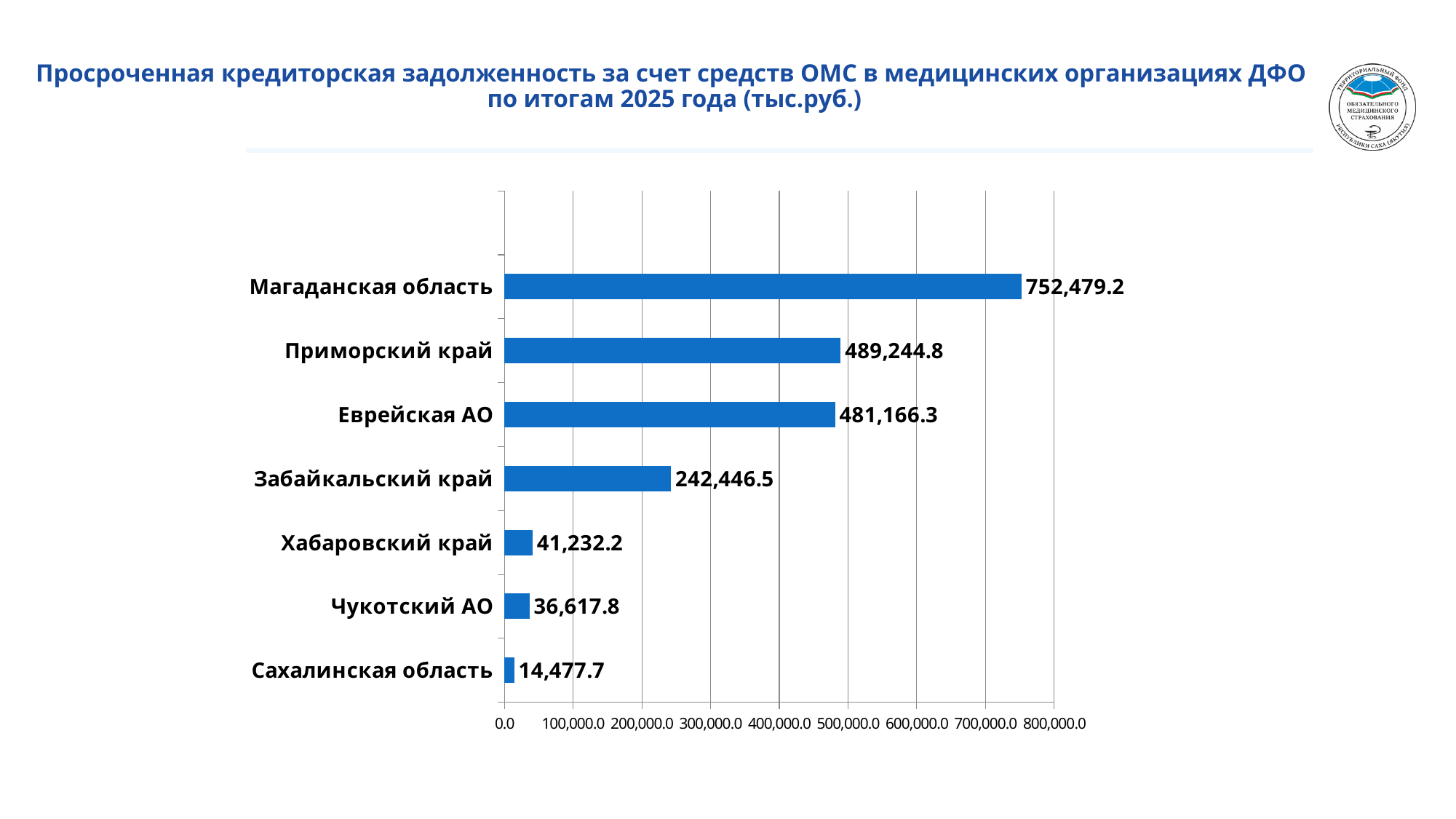
Is the value for Забайкальский край greater or less than 200,000.0? greater Which is larger, the value for Еврейская АО or the value for Забайкальский край? Еврейская АО Which region has the lowest value? Сахалинская область What is the value for Чукотский АО? 36,617.8 Which region has the highest value? Магаданская область How many regions are shown in the chart? 7 What is the difference between the values for Магаданская область and Приморский край? 263,234.4 What type of chart is shown on the slide? bar chart What is the difference between the values for Хабаровский край and Чукотский АО? 4,614.4 What is the value for Забайкальский край? 242,446.5 What is the value for Магаданская область? 752,479.2 What unit is stated in the chart title? тыс.руб.